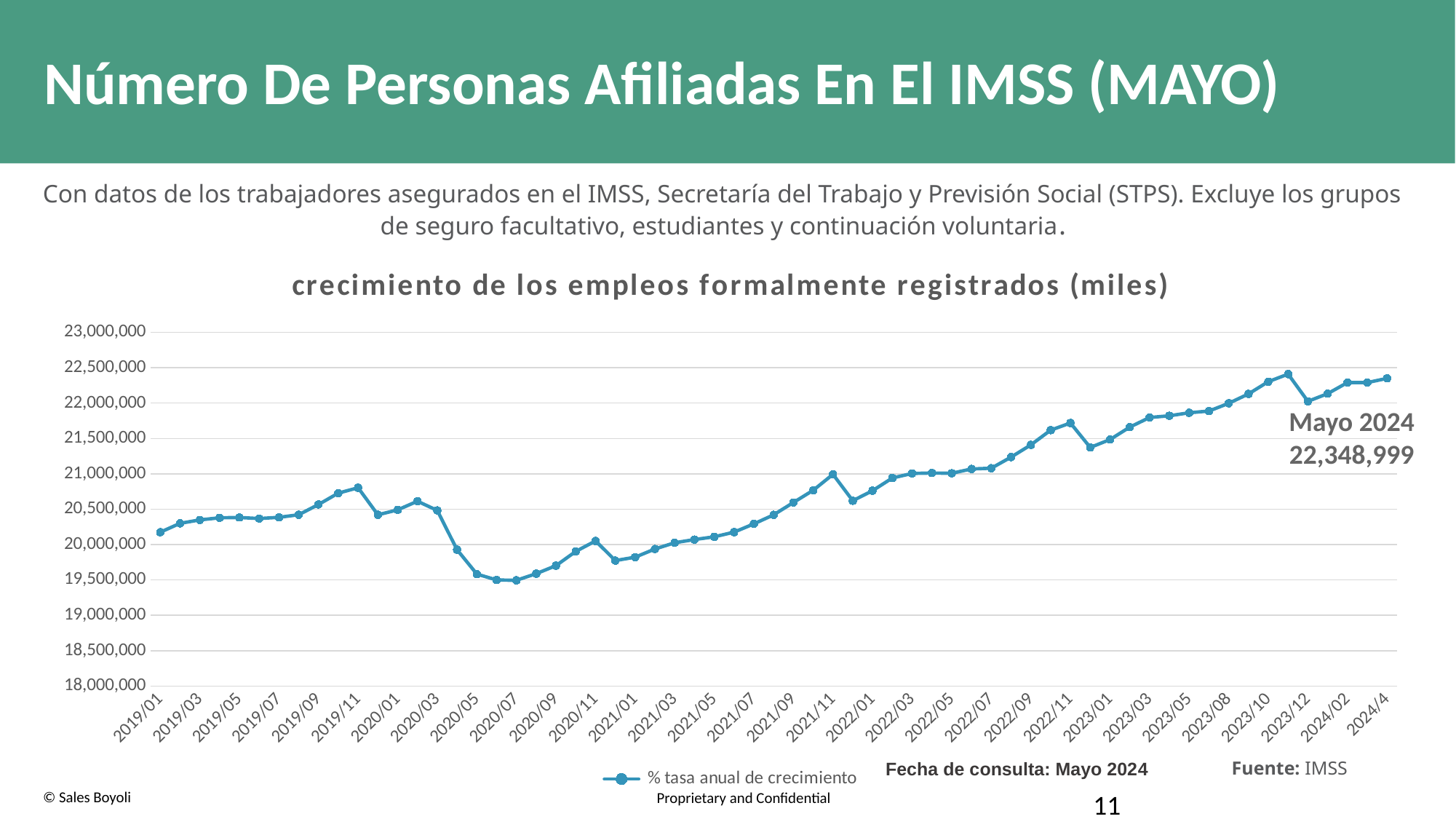
Is the value for 2020/07 greater or less than 20,000,000? less Do the values rise or fall between 2020/03 and 2020/07? fall Is the value for 2021/05 greater or less than 20,500,000? less Which is larger, the value for 2023/10 or the value for 2023/12? 2023/10 What is the title of the chart? crecimiento de los empleos formalmente registrados (miles) Is the value for 2019/01 greater or less than 20,000,000? greater Which is larger, the value for 2019/11 or the value for 2020/07? 2019/11 What kind of chart is shown on the slide? line chart How many series does the chart legend list? 1 What value is labelled on the chart for Mayo 2024? 22,348,999 What is the legend entry for the plotted series? % tasa anual de crecimiento